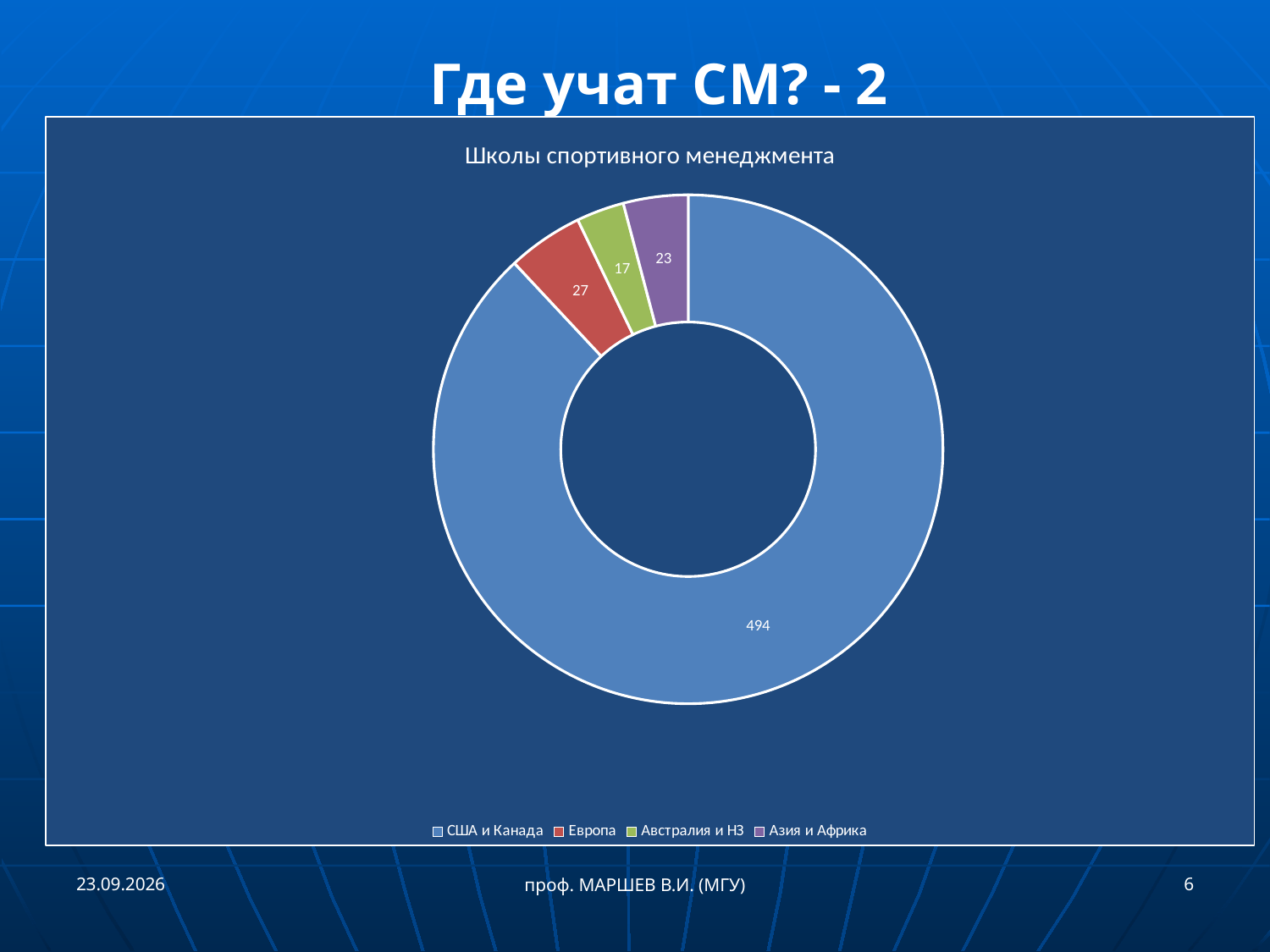
What is the title of the chart? Школы спортивного менеджмента How many categories are shown in the chart? 4 How many entries does the legend list? 4 What is the value for Европа in the chart? 27 What is the value for Азия и Африка in the chart? 23 What is the value for США и Канада in the chart? 494 Which is larger, the value for Европа or the value for Австралия и НЗ? Европа What is the value for Австралия и НЗ in the chart? 17 Which category has the largest value in the chart? США и Канада Which category has the smallest value in the chart? Австралия и НЗ What is the difference between the values for Европа and Азия и Африка? 4 What kind of chart is shown on the slide? Doughnut (pie) chart